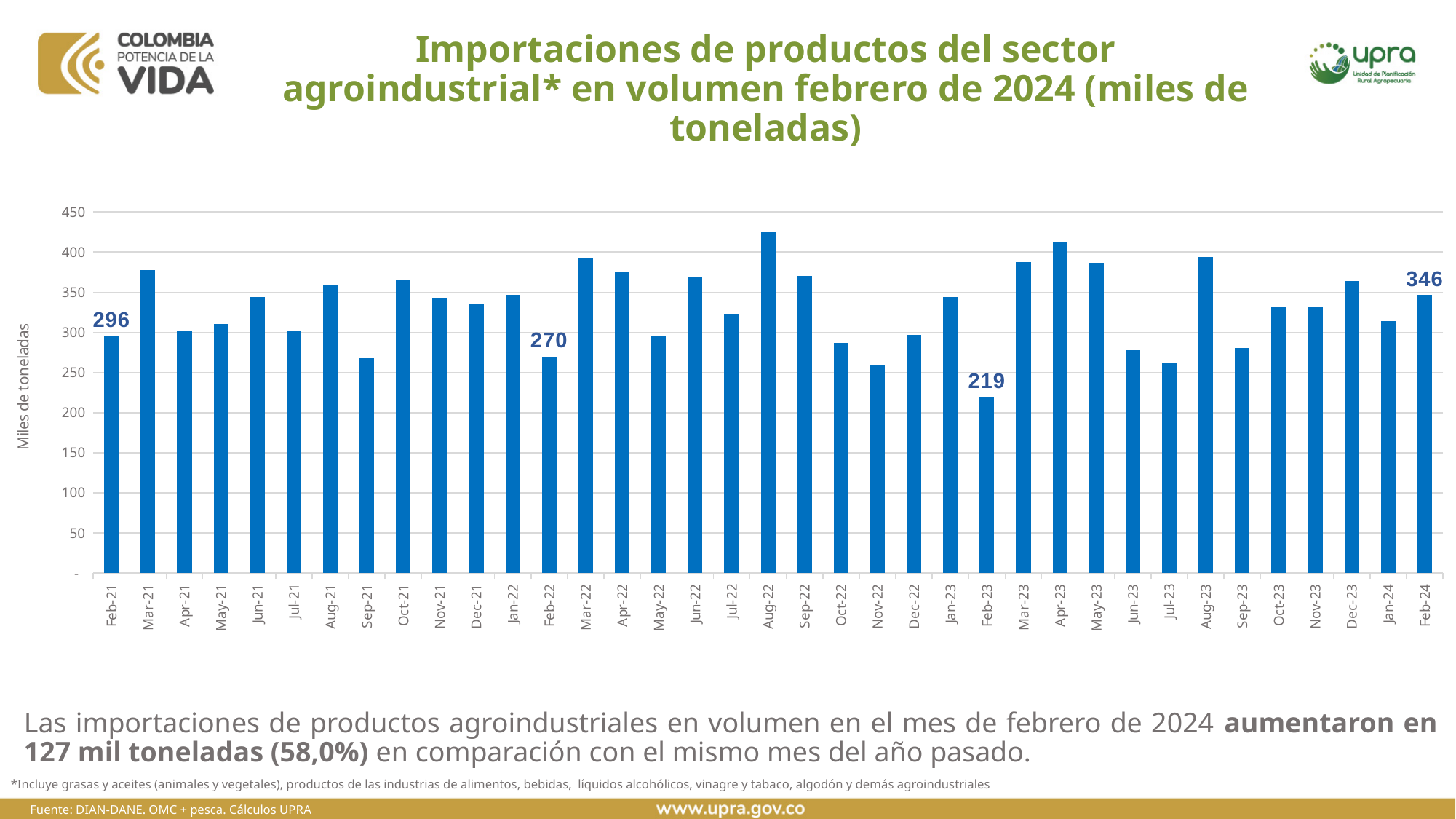
What is the value for Feb-24? 346 Is the value for Aug-22 greater or less than 400? greater What is the value for Feb-23? 219 Is the value for Sep-21 greater or less than 300? less What is the difference between the values for Feb-21 and Feb-22? 26 What is the value for Feb-21? 296 What is the difference between the values for Feb-24 and Feb-23? 127 Which is larger, the value for Feb-21 or the value for Feb-22? Feb-21 What is the value for Feb-22? 270 What kind of chart is shown on the slide? bar chart Which month has the highest value? Aug-22 Which month has the lowest value? Feb-23